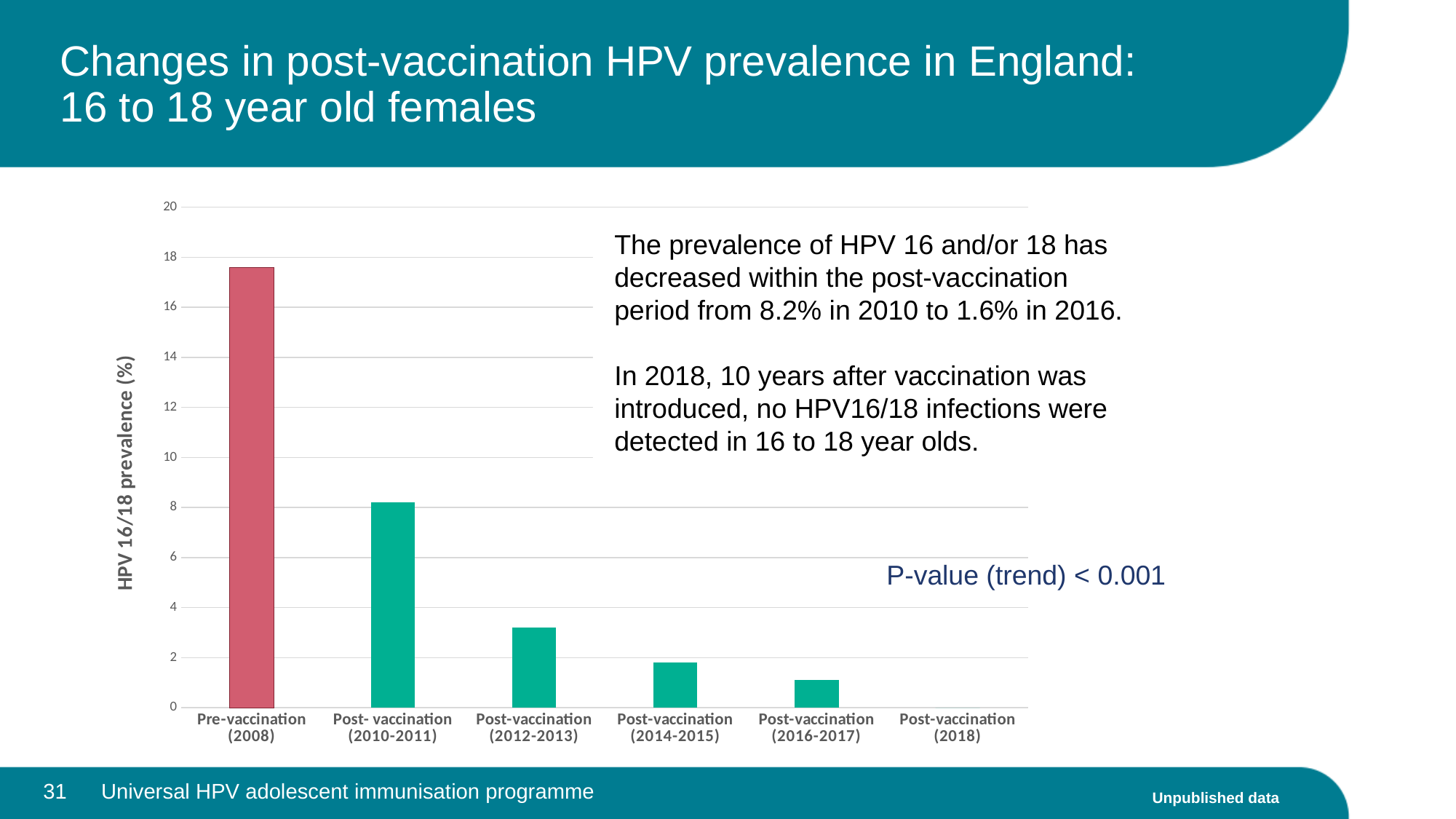
Is the value for Pre-vaccination (2008) greater or less than 16? greater Is the value for Post-vaccination (2016-2017) greater or less than 2? less What kind of chart is shown on the slide? Bar chart Which category has the highest HPV 16/18 prevalence? Pre-vaccination (2008) What is the HPV 16/18 prevalence for Post-vaccination (2018)? 0 Is the value for Post-vaccination (2012-2013) greater or less than 4? less Which category has the lowest HPV 16/18 prevalence? Post-vaccination (2018) Which is larger, the value for Post-vaccination (2012-2013) or Post-vaccination (2014-2015)? Post-vaccination (2012-2013) Do the values rise or fall from left to right along the x axis? Fall How many categories are plotted on the x axis of the chart? 6 What is the label on the y axis of the chart? HPV 16/18 prevalence (%)